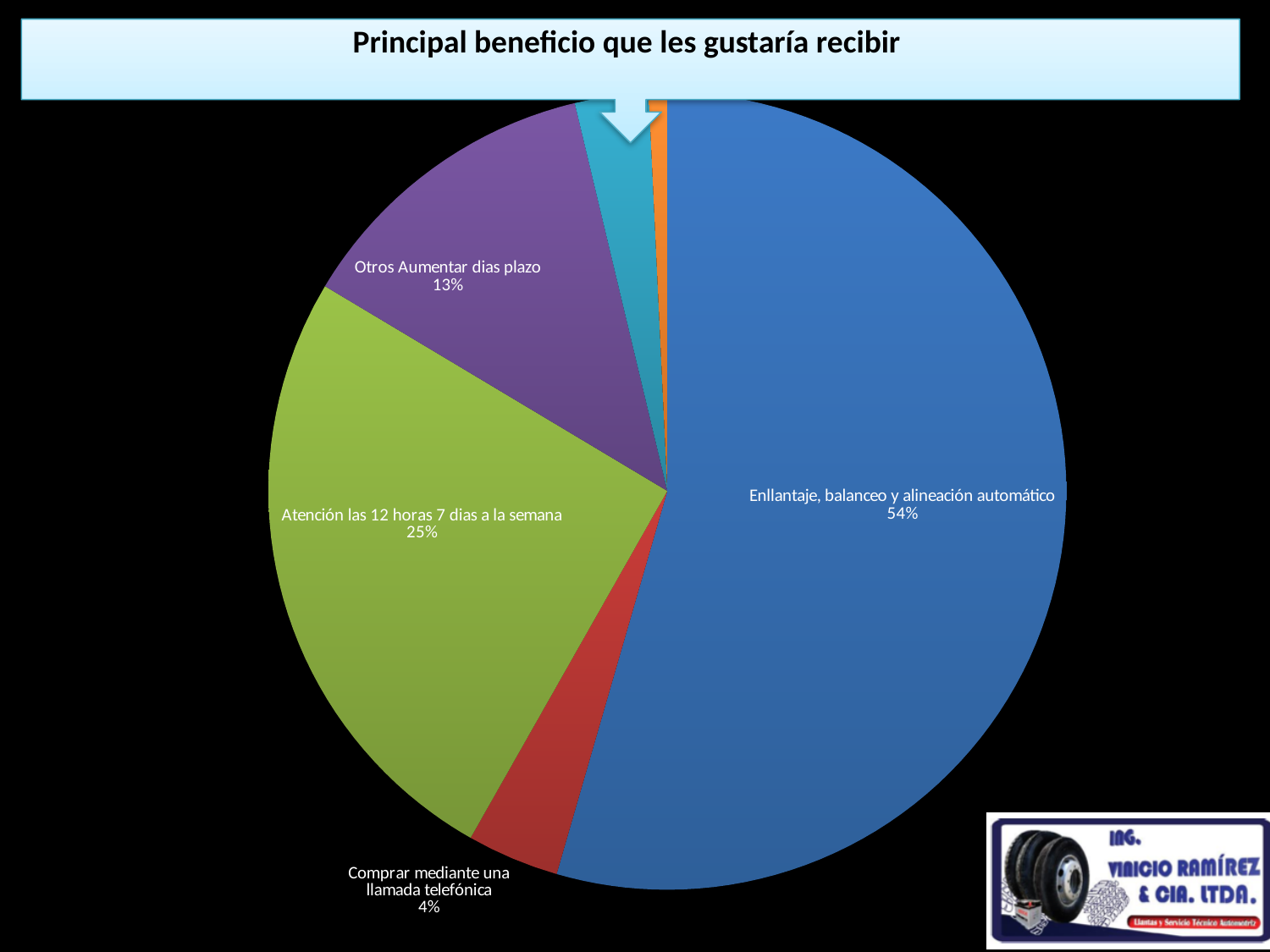
What share of the pie does "Enllantaje, balanceo y alineación automático" have? 54% What is the difference in percentage points between "Enllantaje, balanceo y alineación automático" and "Atención las 12 horas 7 dias a la semana"? 29 What is the title of the chart? Principal beneficio que les gustaría recibir What percentage is shown for "Comprar mediante una llamada telefónica"? 4% What colour is the slice for "Atención las 12 horas 7 dias a la semana"? green Which labeled category has the smallest share of the pie? Comprar mediante una llamada telefónica What kind of chart is shown on the slide? pie chart How many slices does the pie chart have? 6 Which is larger: the share for "Otros Aumentar dias plazo" or the share for "Comprar mediante una llamada telefónica"? Otros Aumentar dias plazo Which labeled category has the largest share of the pie? Enllantaje, balanceo y alineación automático What share of the pie does "Atención las 12 horas 7 dias a la semana" have? 25% What percentage is shown for "Otros Aumentar dias plazo"? 13%